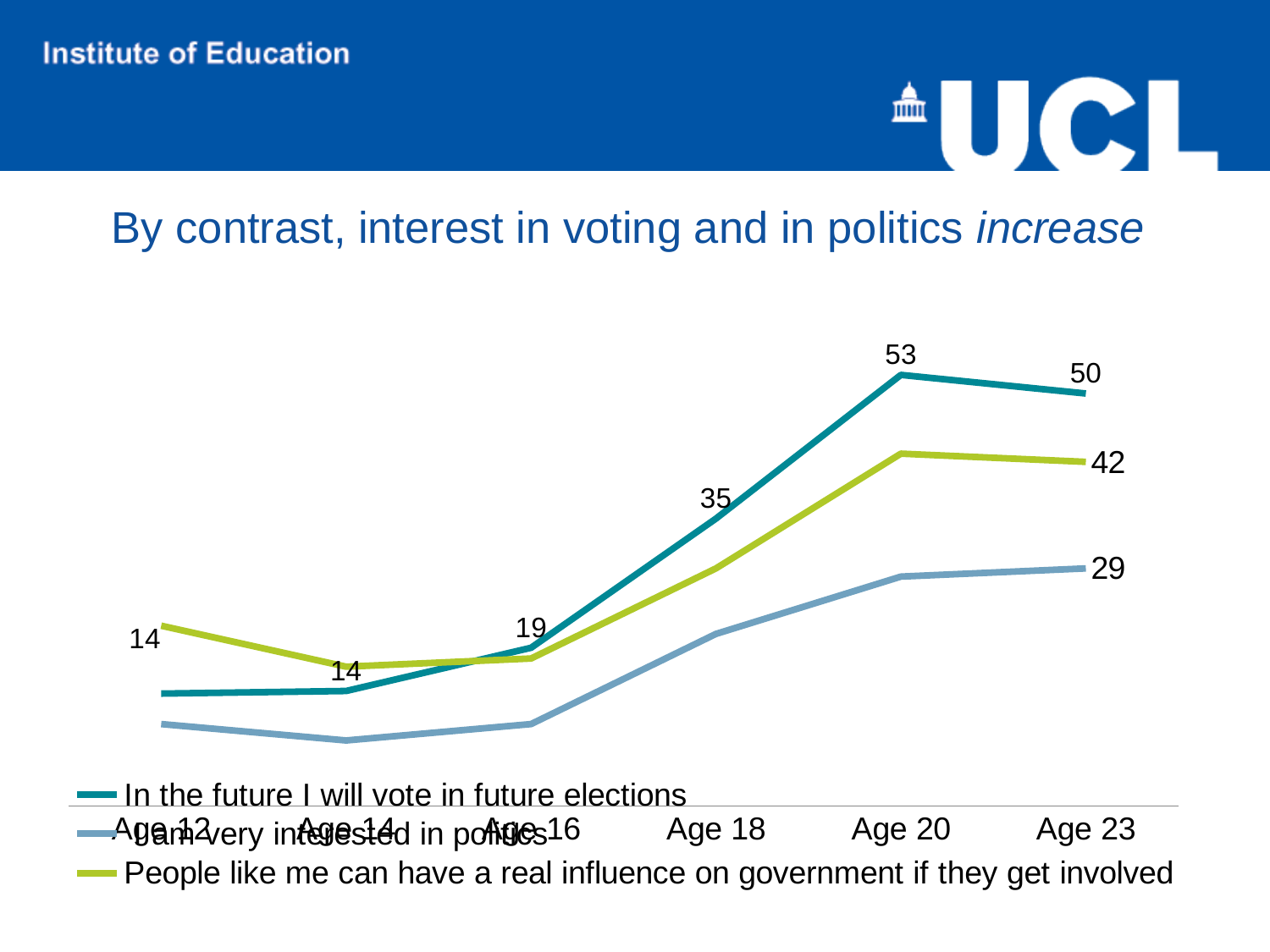
By how much does 'In the future I will vote in future elections' change between Age 20 and Age 23? 3 How many series does the legend list? 3 What is the difference between 'In the future I will vote in future elections' and 'I am very interested in politics' at Age 23? 21 What is the value for 'In the future I will vote in future elections' at Age 23? 50 What kind of chart is shown on the slide? Line chart What is the value for 'I am very interested in politics' at Age 23? 29 At which age does 'In the future I will vote in future elections' reach its highest value? Age 20 How many age points are shown on the x axis? 6 What is the value for 'In the future I will vote in future elections' at Age 20? 53 At Age 23, which series has the larger value: 'In the future I will vote in future elections' or 'People like me can have a real influence on government if they get involved'? In the future I will vote in future elections What is the value for 'In the future I will vote in future elections' at Age 16? 19 What is the value for 'People like me can have a real influence on government if they get involved' at Age 23? 42